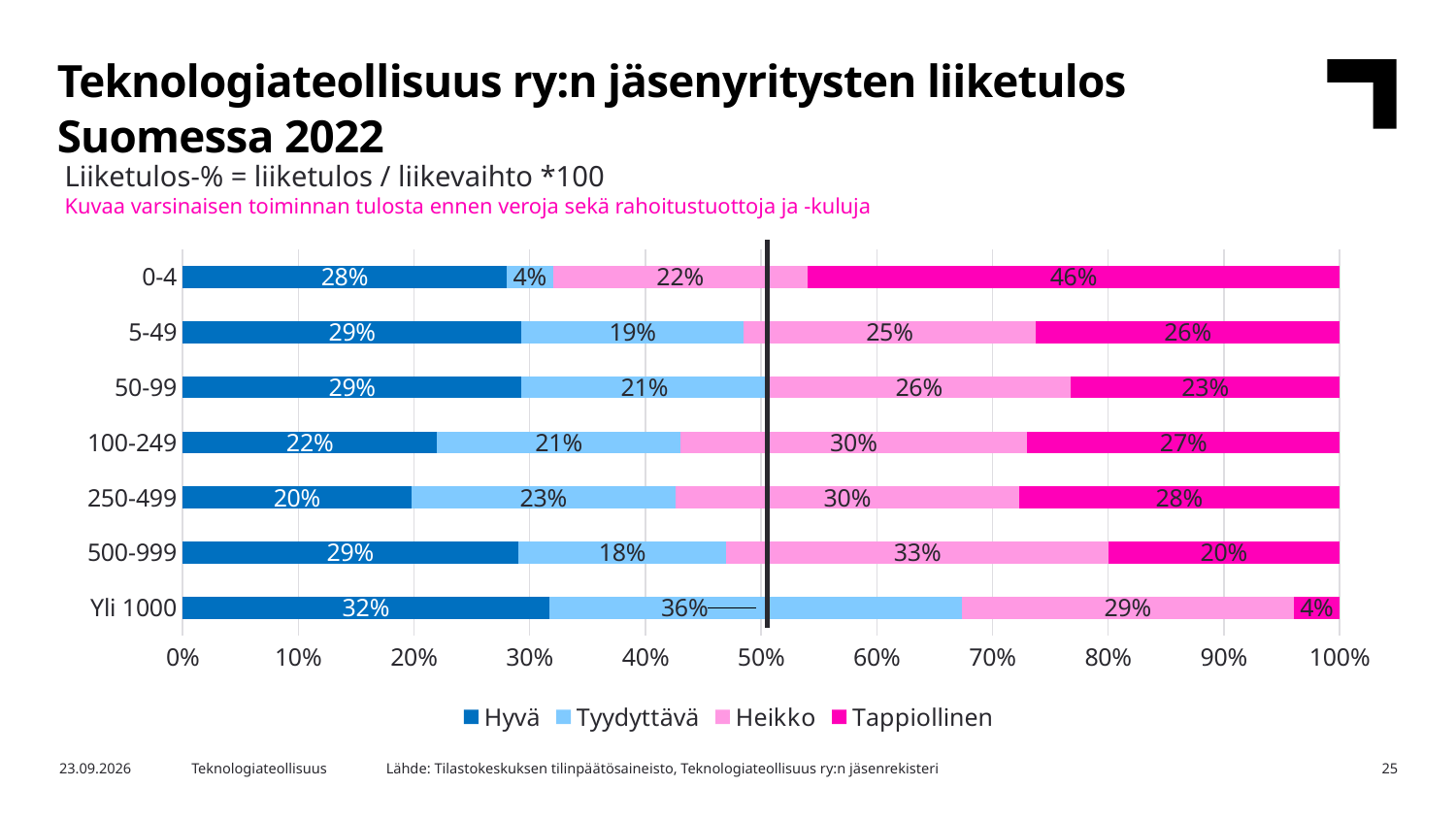
Which category has the lowest Tyydyttävä share? 0-4 Which category has the highest Hyvä share? Yli 1000 What is the Tyydyttävä share for the Yli 1000 category? 36% What is the Tappiollinen share for the 0-4 category? 46% How many company size categories are shown on the chart? 7 Which category has the lowest Tappiollinen share? Yli 1000 Which is larger: the Hyvä share for 100-249 or for 250-499? 100-249 What is the Heikko share for the 500-999 category? 33% What is the difference between the Tappiollinen share for 0-4 and for 5-49? 20 percentage points What is the combined share of Hyvä and Tyydyttävä for the Yli 1000 category? 68% How many series does the legend list? 4 What kind of chart is shown on the slide? Stacked bar chart